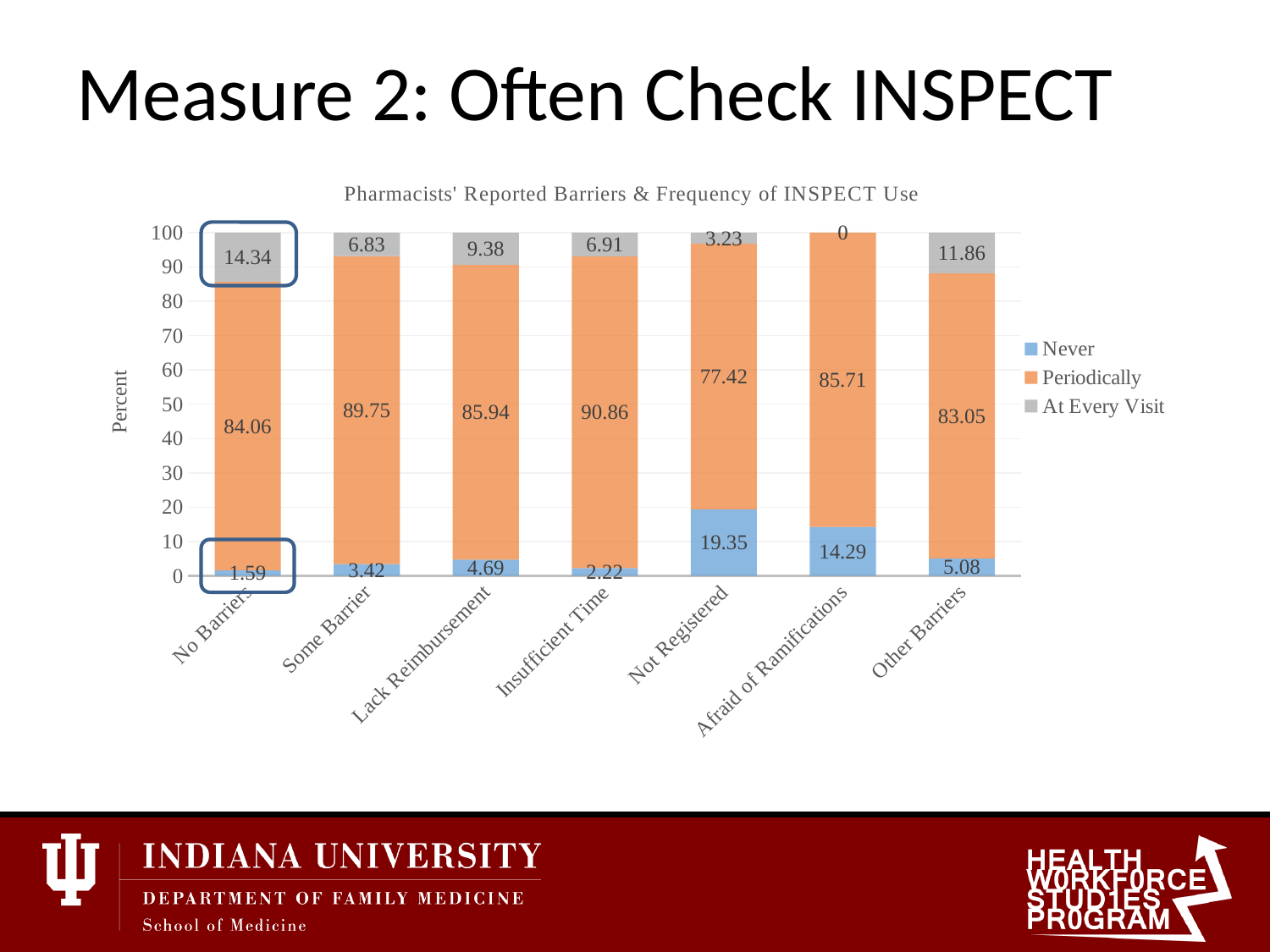
What is the 'At Every Visit' value for No Barriers? 14.34 How many barrier categories are shown on the x axis? 7 Which is larger, the 'Periodically' value for Some Barrier or for Other Barriers? Some Barrier What type of chart is shown on the slide? Stacked bar chart What is the 'Periodically' value for Insufficient Time? 90.86 What is the title of the chart? Pharmacists' Reported Barriers & Frequency of INSPECT Use What is the difference between the 'Never' values for Not Registered and Afraid of Ramifications? 5.06 What is the 'Never' value for Not Registered? 19.35 Which category has the lowest 'At Every Visit' value? Afraid of Ramifications How many series does the legend list? 3 Which category has the highest 'Never' value? Not Registered What is the total of the stacked bar for Not Registered? 100